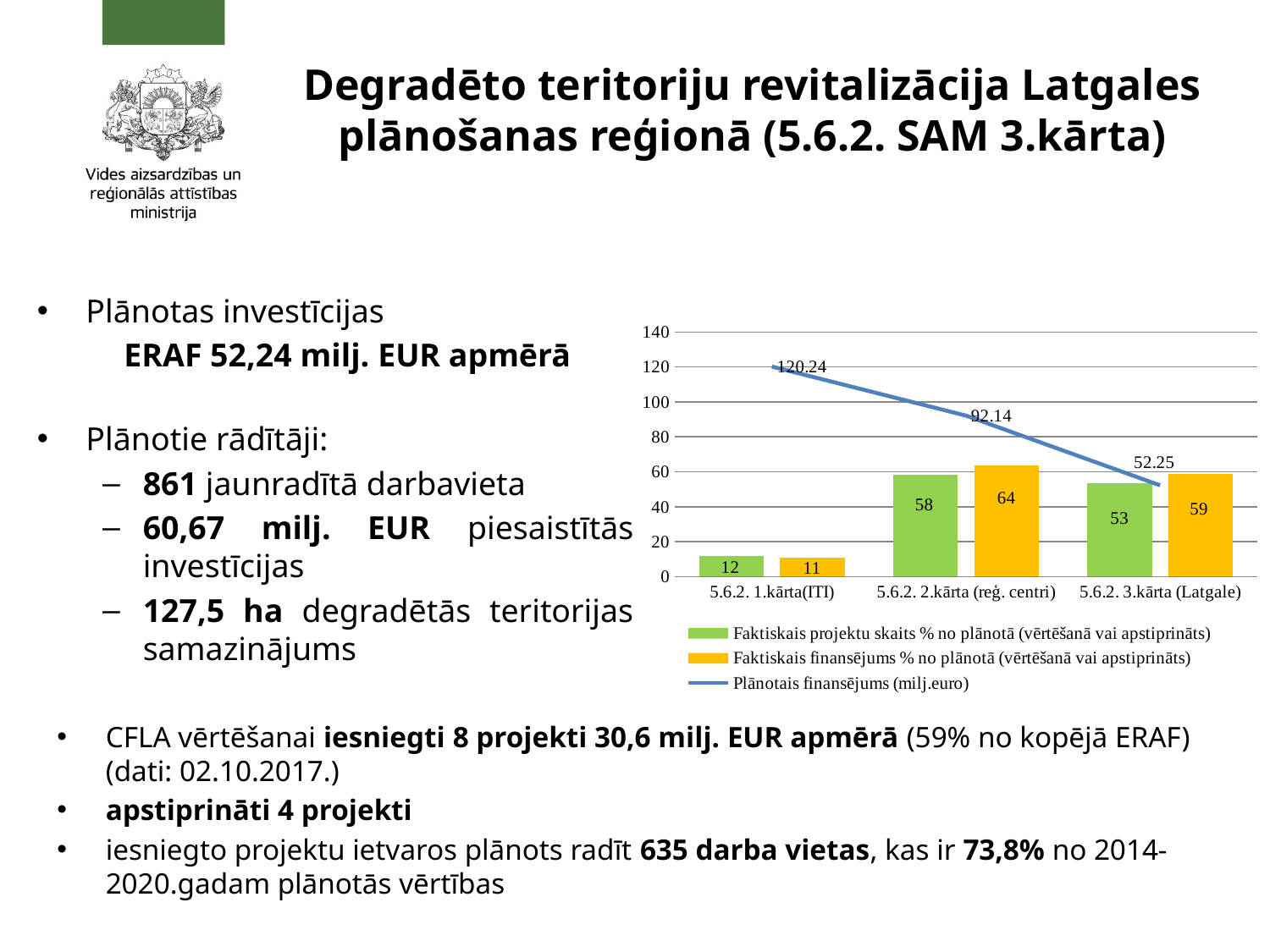
Which category has the highest 'Faktiskais finansējums % no plānotā' value? 5.6.2. 2.kārta (reģ. centri) Which category has the lowest 'Plānotais finansējums (milj.euro)' value? 5.6.2. 3.kārta (Latgale) Does the 'Plānotais finansējums (milj.euro)' line rise or fall from left to right across the categories? fall What is the 'Plānotais finansējums (milj.euro)' value for 5.6.2. 1.kārta(ITI)? 120.24 What is the value of 'Faktiskais projektu skaits % no plānotā' for 5.6.2. 2.kārta (reģ. centri)? 58 What is the difference between the 'Faktiskais projektu skaits %' values for 5.6.2. 2.kārta (reģ. centri) and 5.6.2. 1.kārta(ITI)? 46 How many series does the chart legend list? 3 Which colour represents 'Faktiskais finansējums % no plānotā' in the chart? Orange What is the difference between the 'Plānotais finansējums' values for 5.6.2. 1.kārta(ITI) and 5.6.2. 2.kārta (reģ. centri)? 28.1 For 5.6.2. 3.kārta (Latgale), which is larger: 'Faktiskais projektu skaits %' or 'Faktiskais finansējums %'? Faktiskais finansējums % How many categories are shown on the x axis of the chart? 3 What is the value of 'Faktiskais finansējums % no plānotā' for 5.6.2. 3.kārta (Latgale)? 59